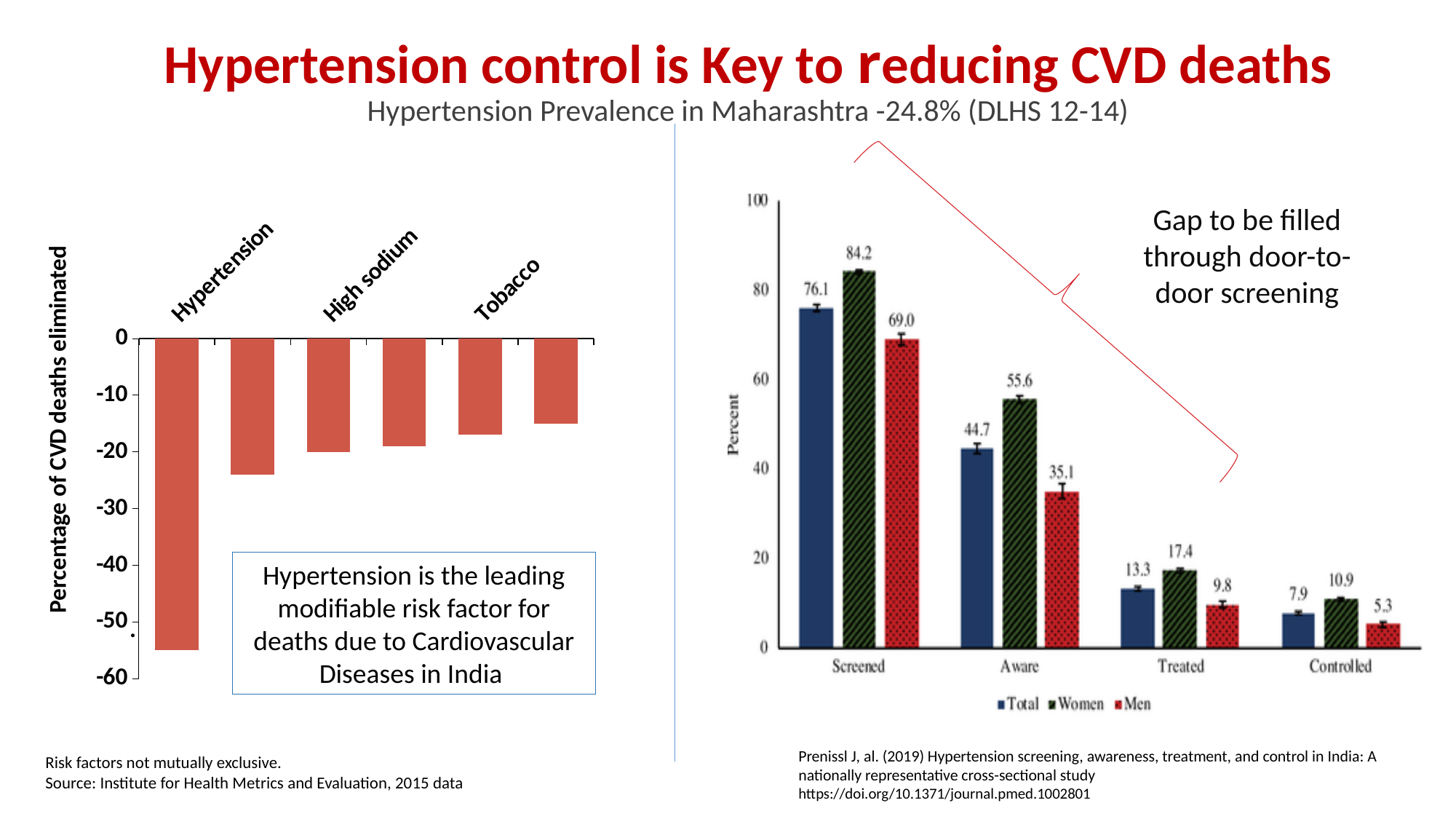
In the right chart, what is the difference between the Total values for Aware and Treated? 31.4 How many series does the legend of the right chart list? 3 In the right chart, what is the value for Men in the Aware category? 35.1 How many categories are shown on the x axis of the right chart? 4 In the right chart, which category has the highest Total value? Screened In the right chart, what is the difference between the Women and Men values in the Screened category? 15.2 In the right chart, which category has the lowest value for Men? Controlled In the left chart, is the value for Hypertension greater or less than -50? less What kind of chart is the left chart showing percentage of CVD deaths eliminated? bar chart In the right chart, what is the Total value for the Controlled category? 7.9 In the right chart, what is the value for Women in the Screened category? 84.2 In the right chart, which is larger in the Treated category: Women or Men? Women